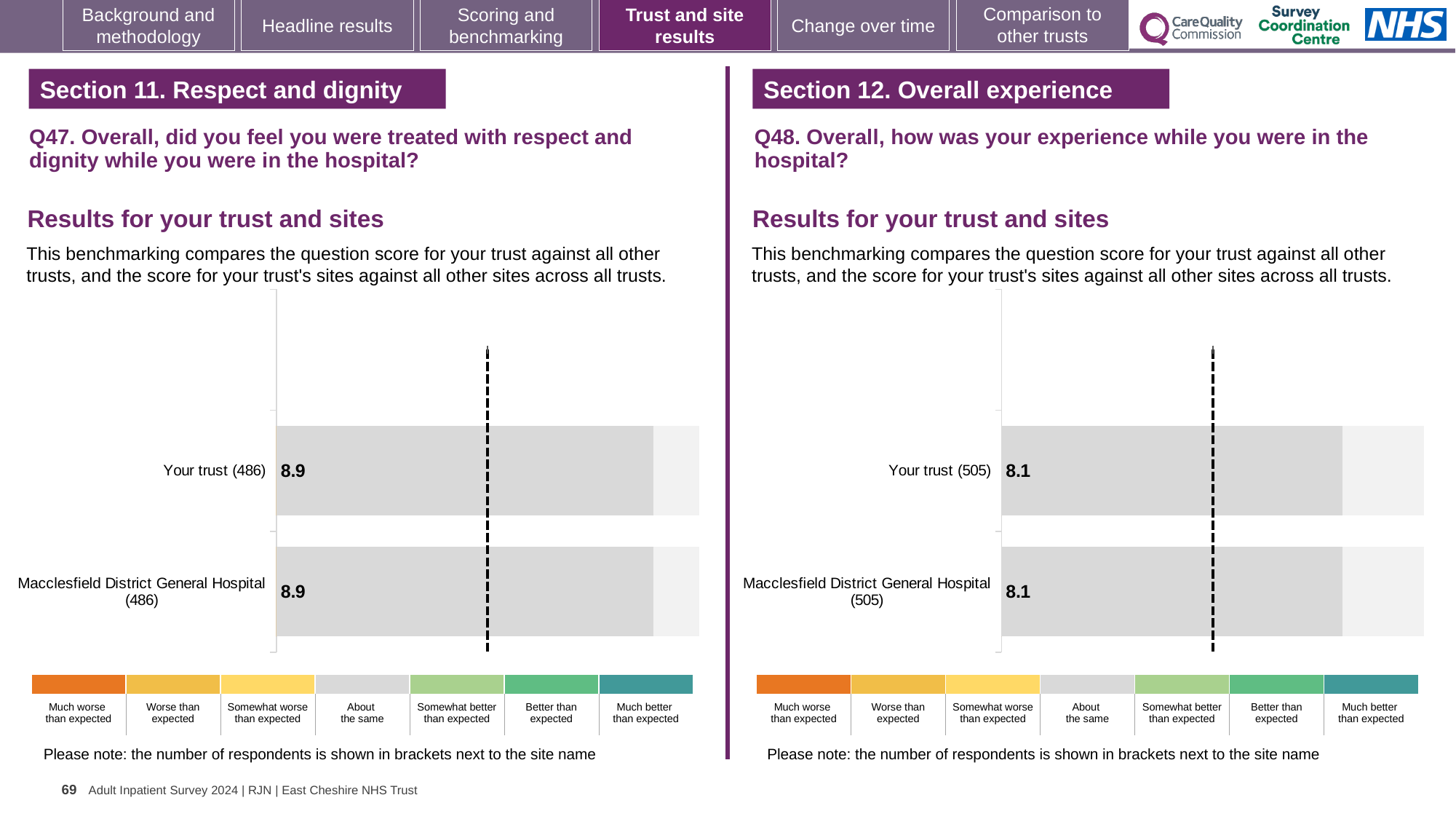
In the Q47 chart on the left, what is the score for Your trust? 8.9 In the Q48 chart on the right, what is the difference between the score for Your trust and the score for Macclesfield District General Hospital? 0 How many bars are plotted in the Q48 chart on the right? 2 How many bars are plotted in the Q47 chart on the left? 2 In the Q47 chart on the left, what is the difference between the score for Your trust and the score for Macclesfield District General Hospital? 0 In the Q48 chart on the right, what is the score for Your trust? 8.1 In the Q48 chart on the right, what is the score for Macclesfield District General Hospital? 8.1 In the Q47 chart on the left, what is the score for Macclesfield District General Hospital? 8.9 What kind of chart is used for the Q48 results on the right? Bar chart In the Q47 chart on the left, how many respondents are shown in brackets next to Your trust? 486 In the Q48 chart on the right, how many respondents are shown in brackets next to Macclesfield District General Hospital? 505